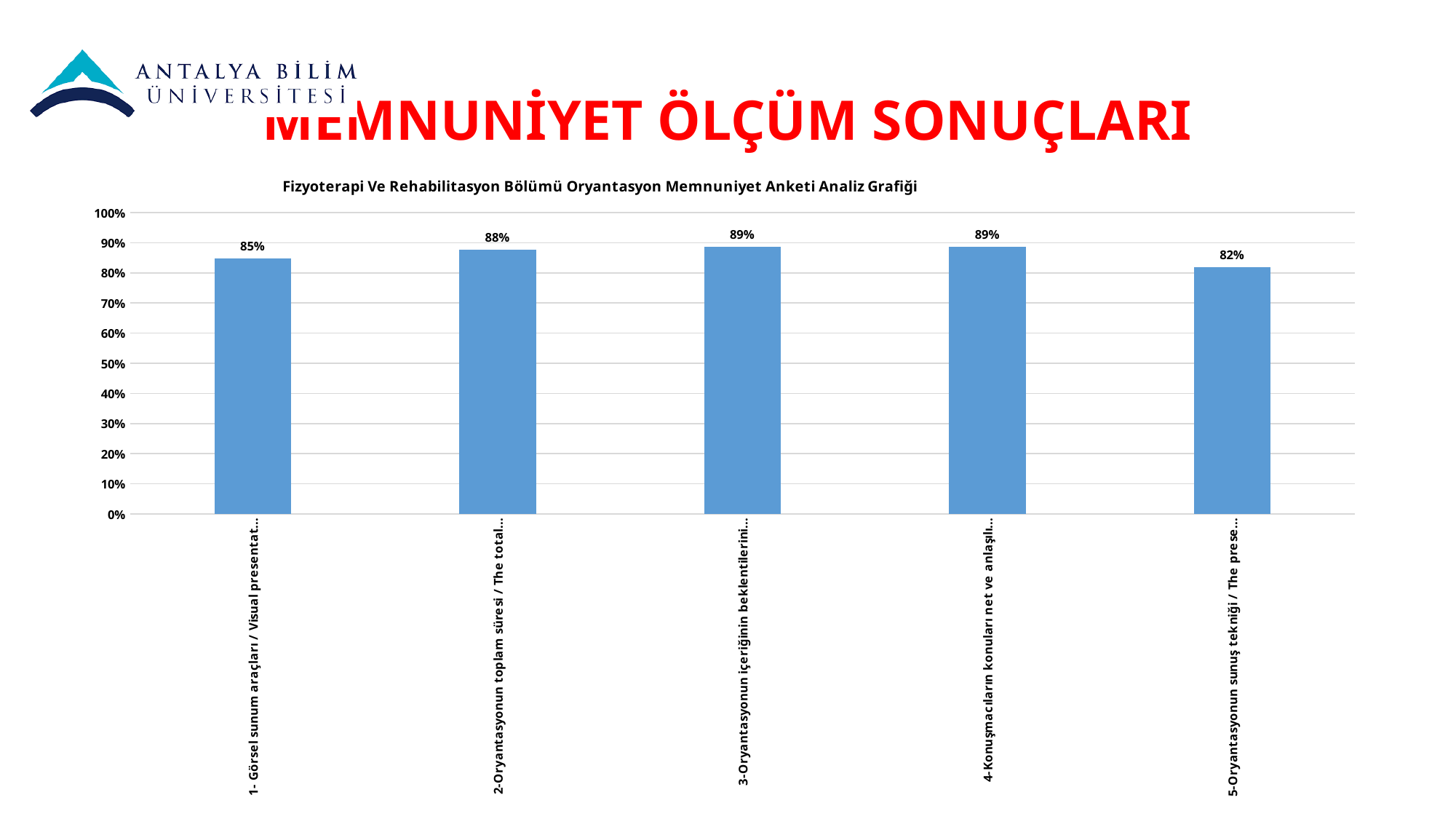
Is the value for category 5 greater or less than 90%? less How many categories are shown on the chart? 5 What is the difference between the values for category 3 and category 1? 4% What is the value for category 5 (Oryantasyonun sunuş tekniği)? 82% Which is larger, the value for category 1 or the value for category 2? category 2 Which category has the lowest value? 5-Oryantasyonun sunuş tekniği What is the highest value shown on the chart? 89% What is the difference between the values for category 2 and category 5? 6% What kind of chart is shown on the slide? bar chart What is the title of the chart? Fizyoterapi Ve Rehabilitasyon Bölümü Oryantasyon Memnuniyet Anketi Analiz Grafiği What is the value for category 2 (Oryantasyonun toplam süresi)? 88% What is the value for category 1 (Görsel sunum araçları / Visual presentation)? 85%